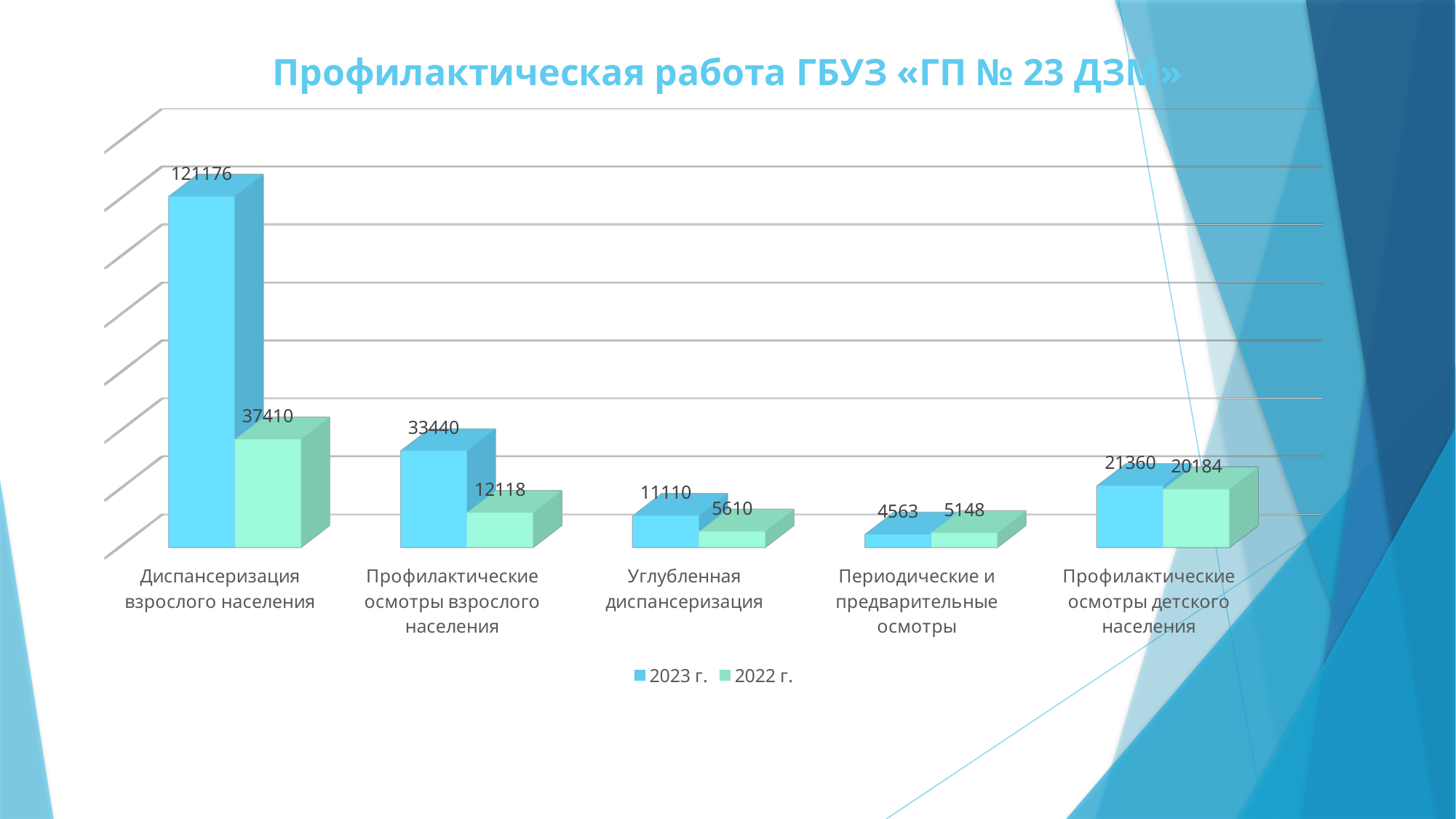
What is the value for 2022 г. for Профилактические осмотры взрослого населения? 12118 What is the value for 2022 г. for Профилактические осмотры детского населения? 20184 Which category has the lowest value for 2022 г.? Периодические и предварительные осмотры Which category has the highest value for 2023 г.? Диспансеризация взрослого населения What kind of chart is shown on the slide? Bar chart What is the value for 2023 г. for Диспансеризация взрослого населения? 121176 What is the difference between the 2023 г. and 2022 г. values for Диспансеризация взрослого населения? 83766 For Периодические и предварительные осмотры, which is larger: the 2023 г. value or the 2022 г. value? 2022 г. How many categories are shown on the x axis? 5 What is the value for 2023 г. for Углубленная диспансеризация? 11110 How many series does the legend list? 2 What is the difference between the 2023 г. and 2022 г. values for Углубленная диспансеризация? 5500